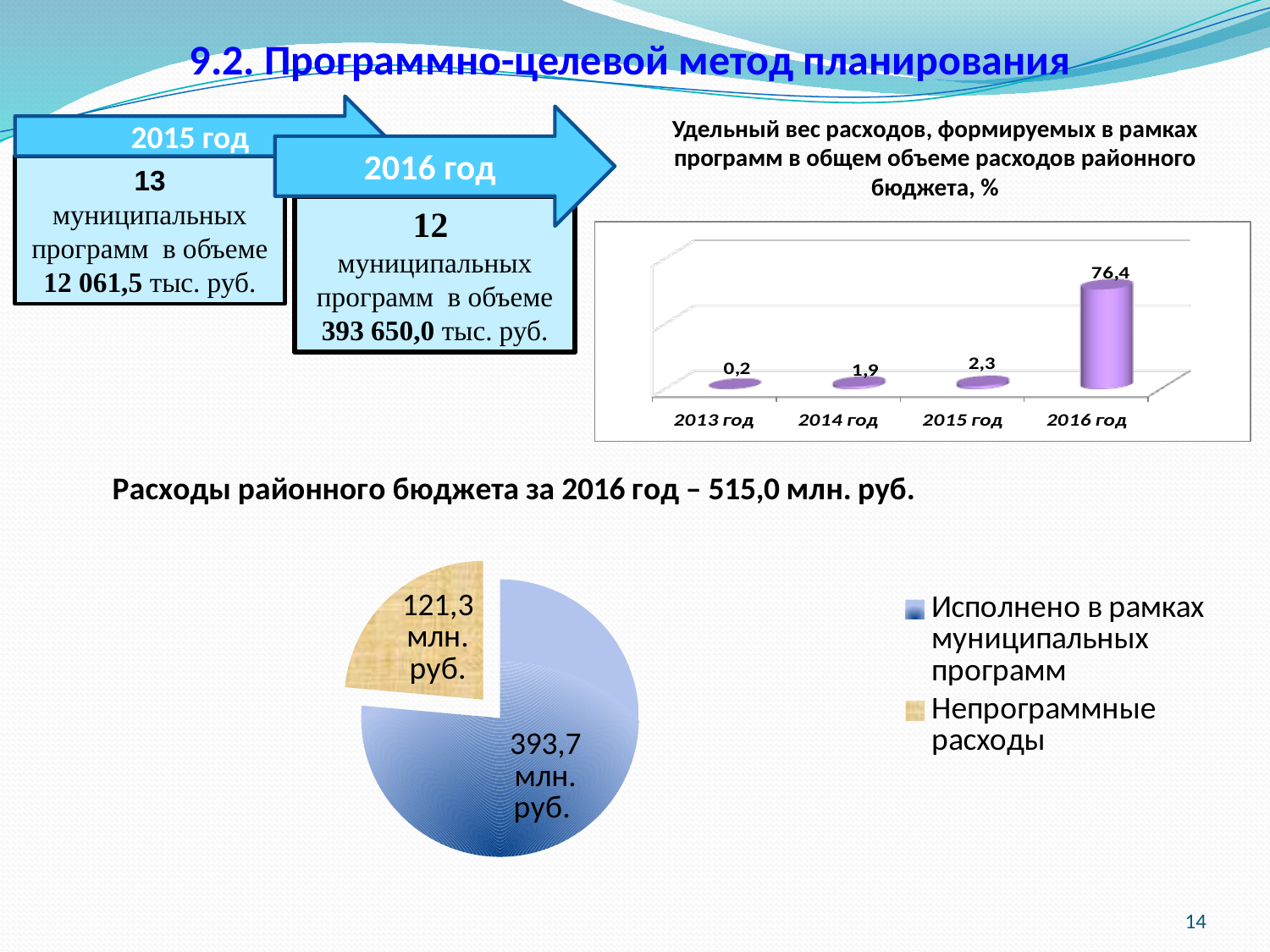
In the bar chart titled 'Удельный вес расходов, формируемых в рамках программ в общем объеме расходов районного бюджета, %', what is the value for 2016 год? 76,4 In the pie chart at the bottom of the slide, what is the value for 'Непрограммные расходы'? 121,3 млн. руб. What kind of chart is the one in the top right of the slide? bar chart In the bar chart titled 'Удельный вес расходов, формируемых в рамках программ...', do the values rise or fall from 2013 год to 2016 год? rise In the bar chart titled 'Удельный вес расходов, формируемых в рамках программ...', what is the value for 2014 год? 1,9 In the bar chart titled 'Удельный вес расходов, формируемых в рамках программ...', how many years are shown on the x axis? 4 In the bar chart titled 'Удельный вес расходов, формируемых в рамках программ...', what is the value for 2013 год? 0,2 In the bar chart titled 'Удельный вес расходов, формируемых в рамках программ...', what is the difference between the values for 2016 год and 2015 год? 74,1 In the pie chart at the bottom of the slide, how many entries does the legend list? 2 In the pie chart at the bottom of the slide, what is the value for 'Исполнено в рамках муниципальных программ'? 393,7 млн. руб. In the bar chart titled 'Удельный вес расходов, формируемых в рамках программ...', which year has the highest value? 2016 год In the bar chart titled 'Удельный вес расходов, формируемых в рамках программ...', which year has the lowest value? 2013 год